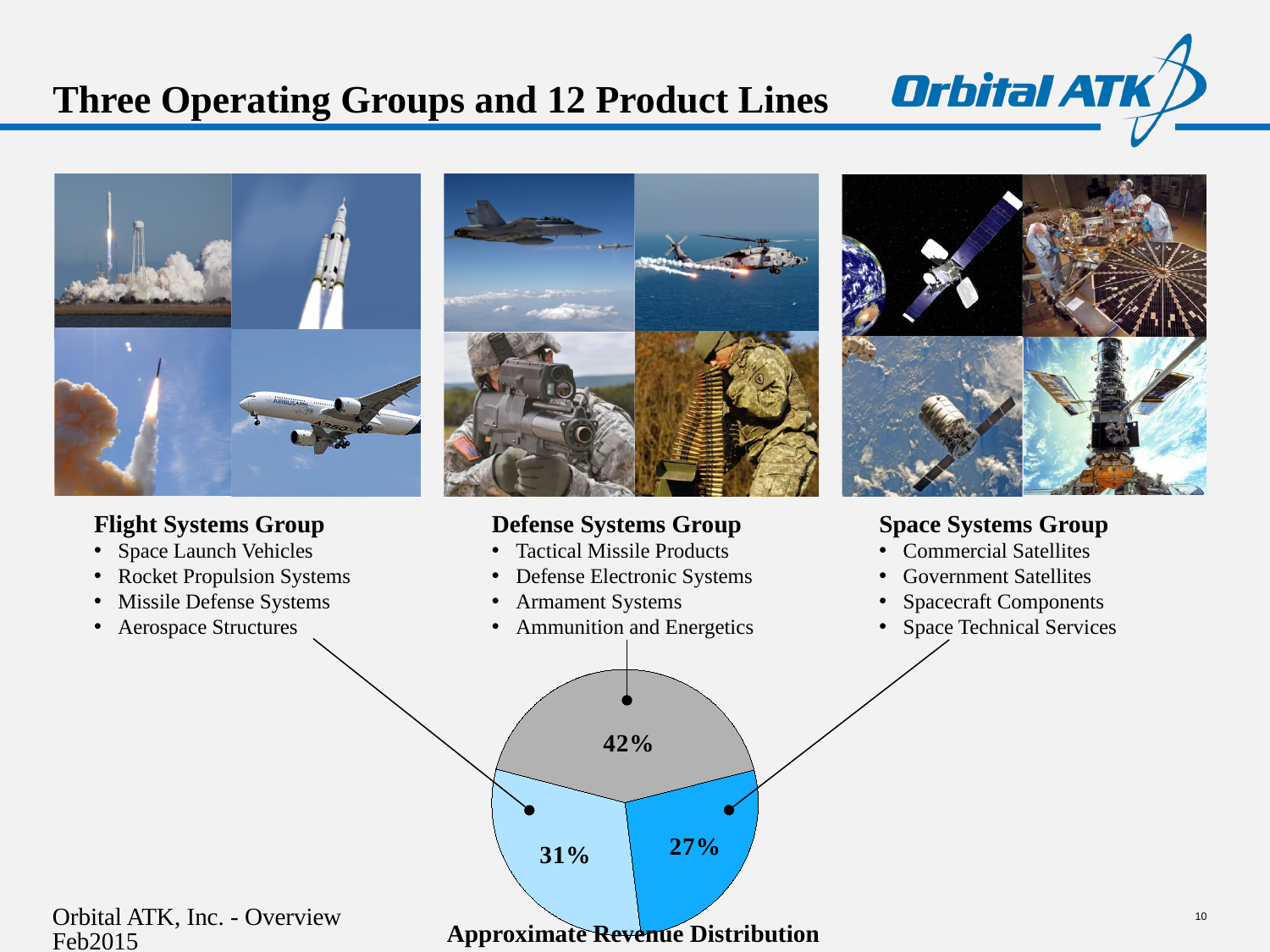
What share of revenue does the pie chart attribute to the Space Systems Group? 27% Which operating group has the largest slice of the pie chart? Defense Systems Group Which is larger in the pie chart, the Flight Systems Group share or the Space Systems Group share? Flight Systems Group What share of revenue does the pie chart attribute to the Flight Systems Group? 31% What colour is the slice labelled 42% in the pie chart? gray Which operating group has the smallest slice of the pie chart? Space Systems Group What is the difference in percentage points between the Flight Systems Group slice and the Space Systems Group slice? 4 What share of revenue does the pie chart attribute to the Defense Systems Group? 42% How many slices does the pie chart have? 3 What is the title of the pie chart? Approximate Revenue Distribution What is the difference in percentage points between the Defense Systems Group slice and the Space Systems Group slice? 15 What kind of chart is shown at the bottom of the slide? pie chart